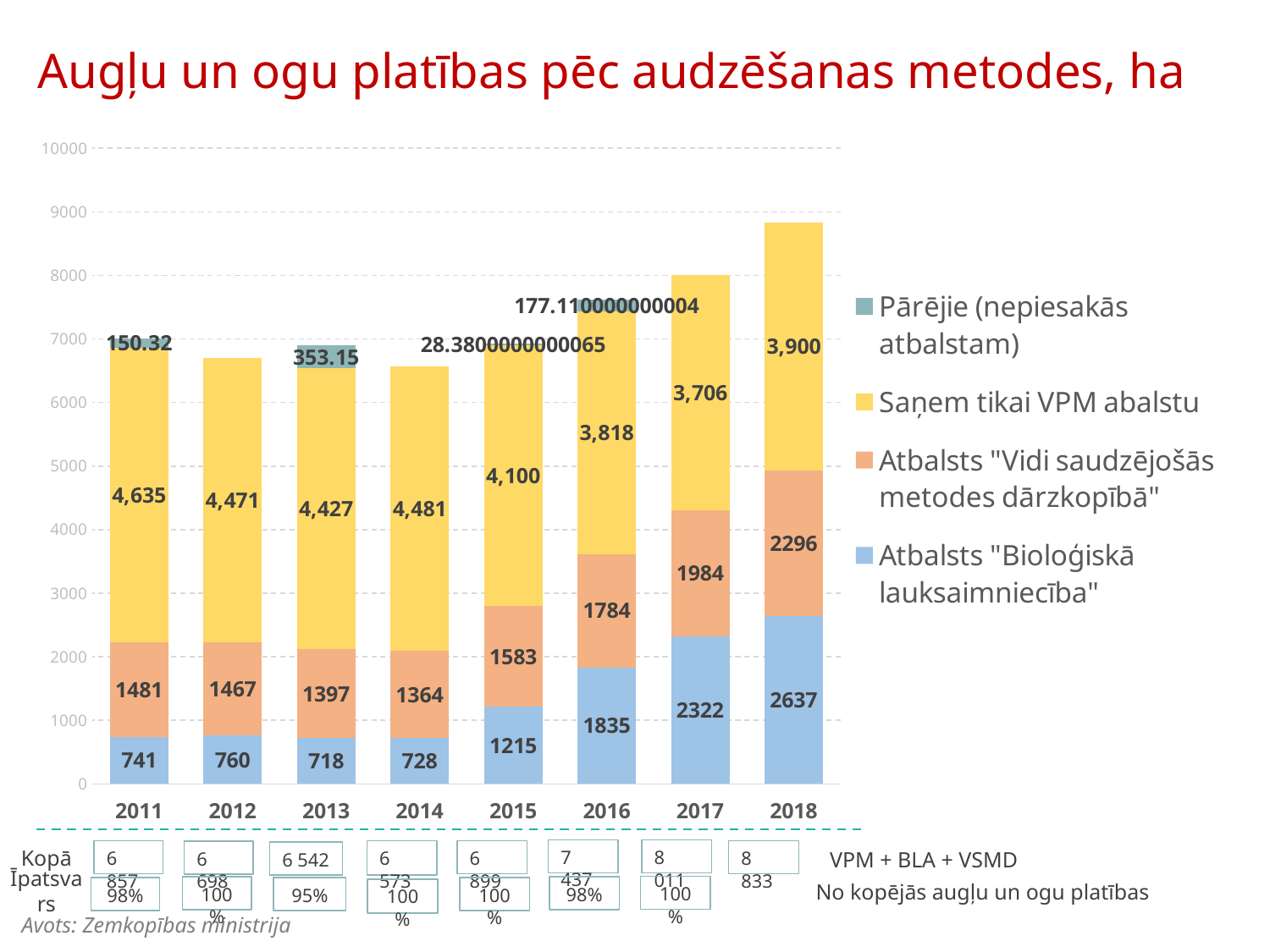
What is the difference between the Atbalsts "Bioloģiskā lauksaimniecība" values for 2018 and 2011? 1896 In which year is the value for Saņem tikai VPM abalstu lowest? 2017 What is the difference between the Saņem tikai VPM abalstu values for 2011 and 2018? 735 How many years are shown on the x axis? 8 What is the value for Atbalsts "Bioloģiskā lauksaimniecība" in 2018? 2637 How many series does the legend list? 4 What is the value for Atbalsts "Vidi saudzējošās metodes dārzkopībā" in 2015? 1583 What kind of chart is shown on the slide? Stacked bar chart Which year has the larger value for Atbalsts "Vidi saudzējošās metodes dārzkopībā", 2016 or 2017? 2017 Which colour represents Saņem tikai VPM abalstu in the legend? Yellow In which year is the value for Atbalsts "Bioloģiskā lauksaimniecība" highest? 2018 What is the value for Saņem tikai VPM abalstu in 2011? 4,635